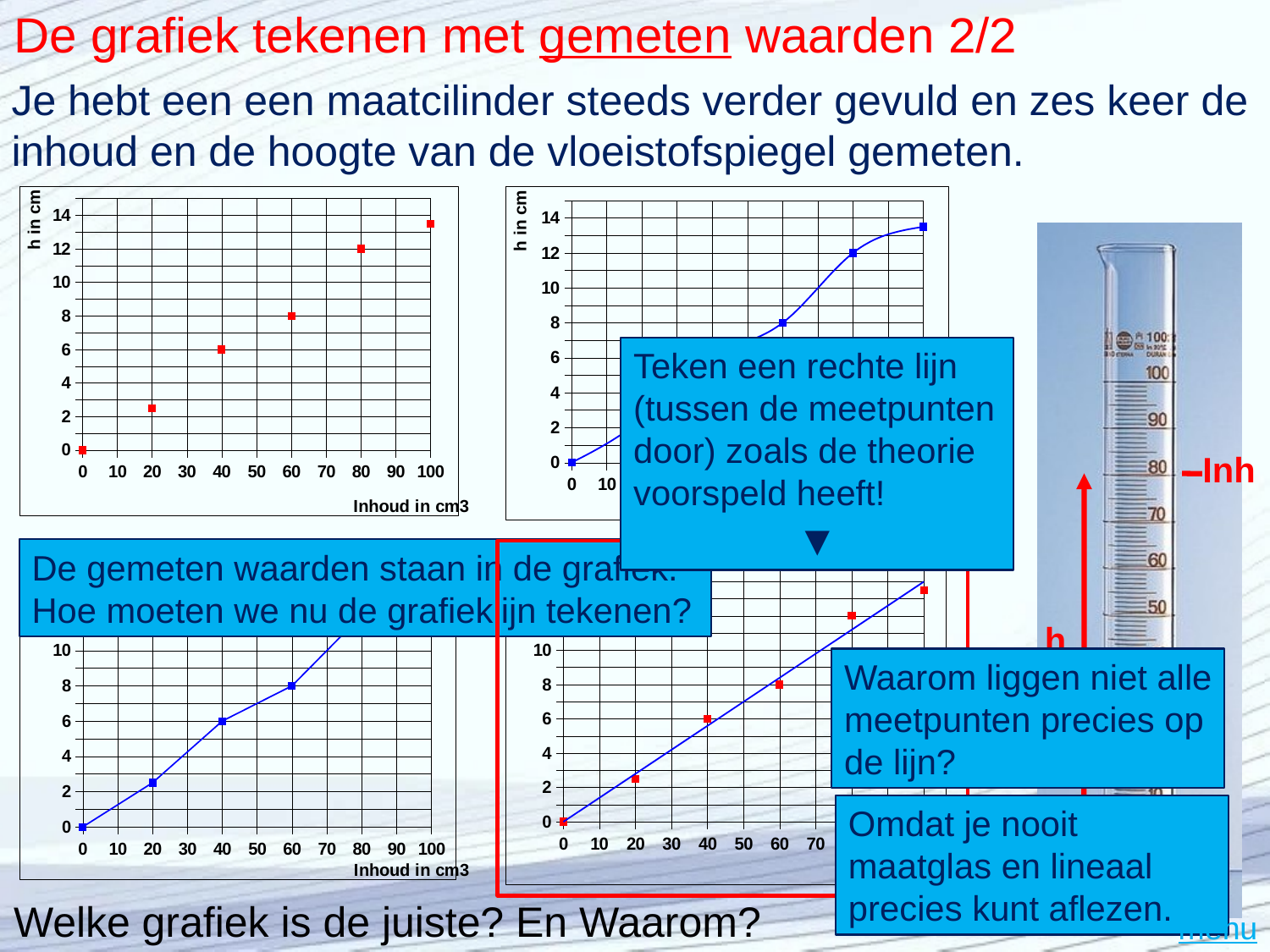
On the top-left chart, at which Inhoud value is h the lowest? 0 What is the label of the vertical axis on the top-left chart? h in cm On the top-left chart, do the values of h rise or fall as Inhoud increases? rise On the top-left chart, is the value of h at an Inhoud of 100 cm3 greater or less than 12? greater On the top-left chart, what is the value of h in cm at an Inhoud of 0 cm3? 0 On the top-left chart, what is the value of h in cm at an Inhoud of 80 cm3? 12 On the top-left chart, is the value of h at an Inhoud of 20 cm3 greater or less than 4? less On the top-left chart, what is the value of h in cm at an Inhoud of 40 cm3? 6 On the top-left chart, what is the difference in h between an Inhoud of 80 cm3 and an Inhoud of 60 cm3? 4 On the top-left chart, at which Inhoud value is h the highest? 100 On the top-left chart, what is the value of h in cm at an Inhoud of 60 cm3? 8 On the top-left chart, how many measurement points are plotted? 6